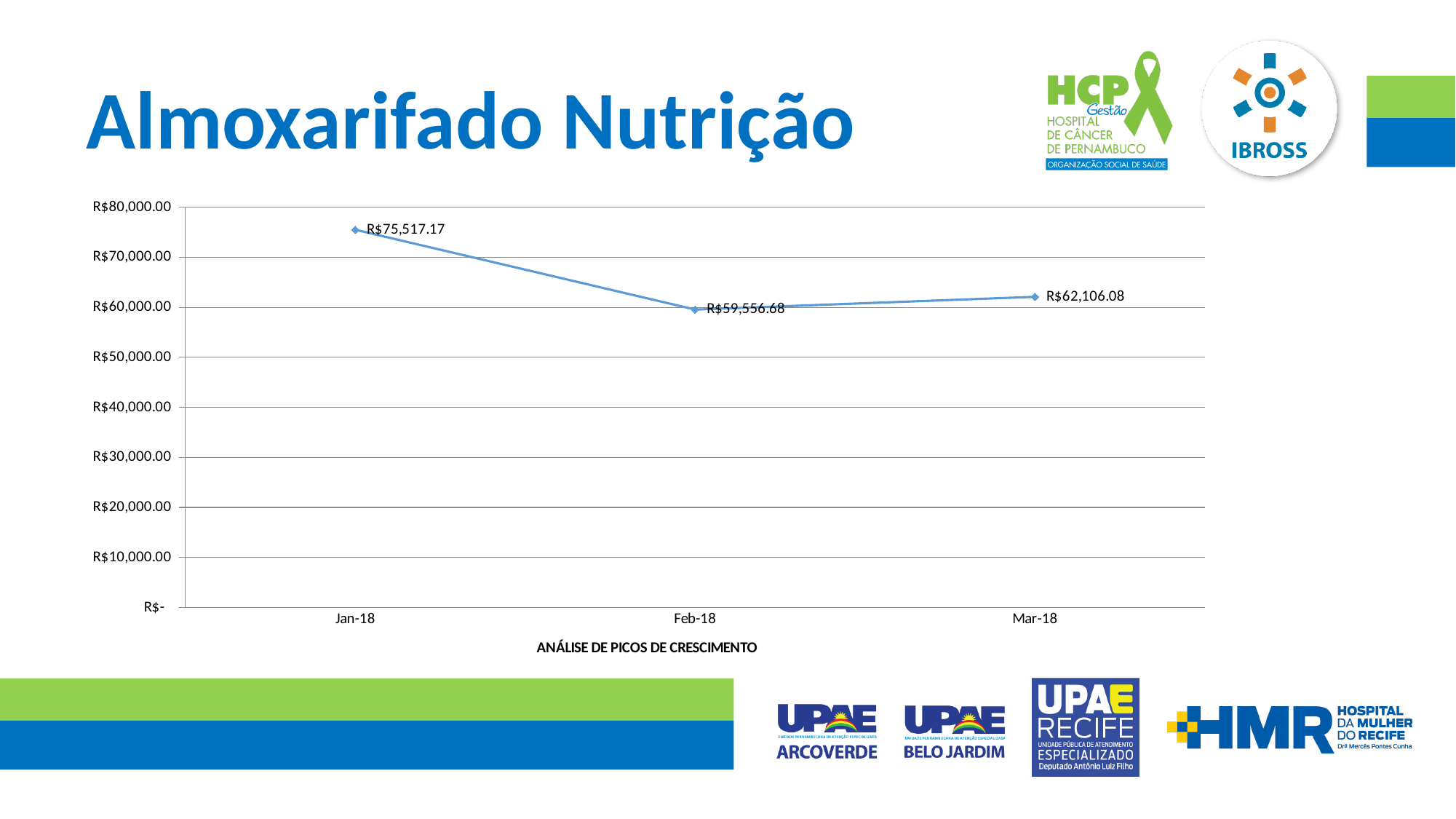
Which month has the lowest value? Feb-18 What kind of chart is shown on the slide? line chart What is the label shown below the x axis of the chart? ANÁLISE DE PICOS DE CRESCIMENTO How many months are plotted on the chart? 3 What is the value for Mar-18? R$62,106.08 Which month has the highest value? Jan-18 What is the difference between the values for Mar-18 and Feb-18? R$2,549.40 What is the value for Jan-18? R$75,517.17 What is the value for Feb-18? R$59,556.68 Which is larger, the value for Feb-18 or the value for Mar-18? Mar-18 Is the value for Jan-18 greater or less than R$70,000.00? greater What is the difference between the values for Jan-18 and Feb-18? R$15,960.49